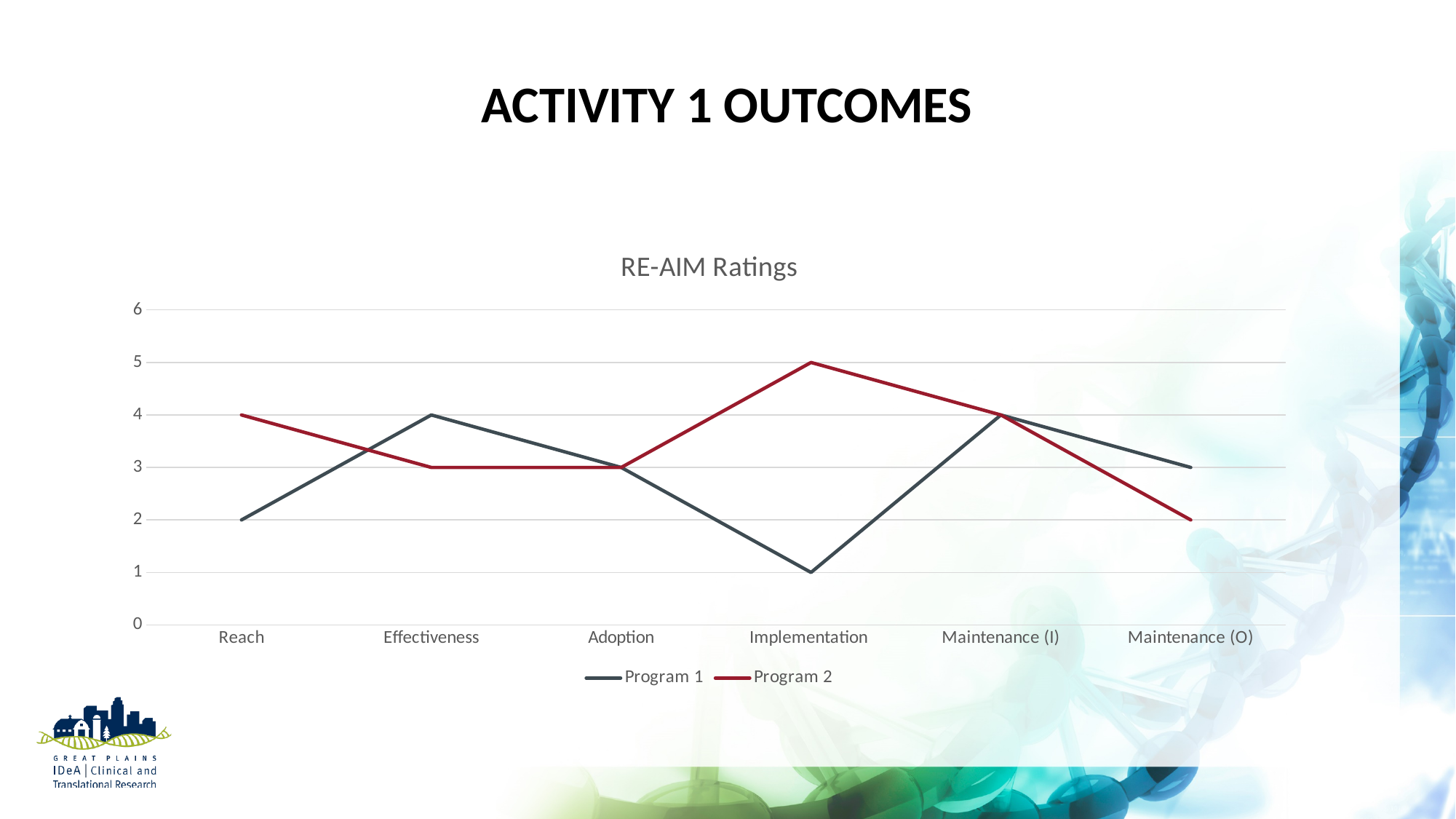
What is the rating for Program 2 at Maintenance (O)? 2 Which program has the higher rating at Effectiveness? Program 1 What is the rating for Program 1 at Implementation? 1 What is the title of the chart? RE-AIM Ratings How many series does the legend list? 2 At which category does Program 1 have its lowest rating? Implementation What is the rating for Program 1 at Reach? 2 How many categories are shown on the x axis? 6 At which category does Program 2 reach its highest rating? Implementation What is the rating for Program 2 at Implementation? 5 What is the difference between Program 2 and Program 1 at Implementation? 4 What kind of chart is shown on the slide? line chart